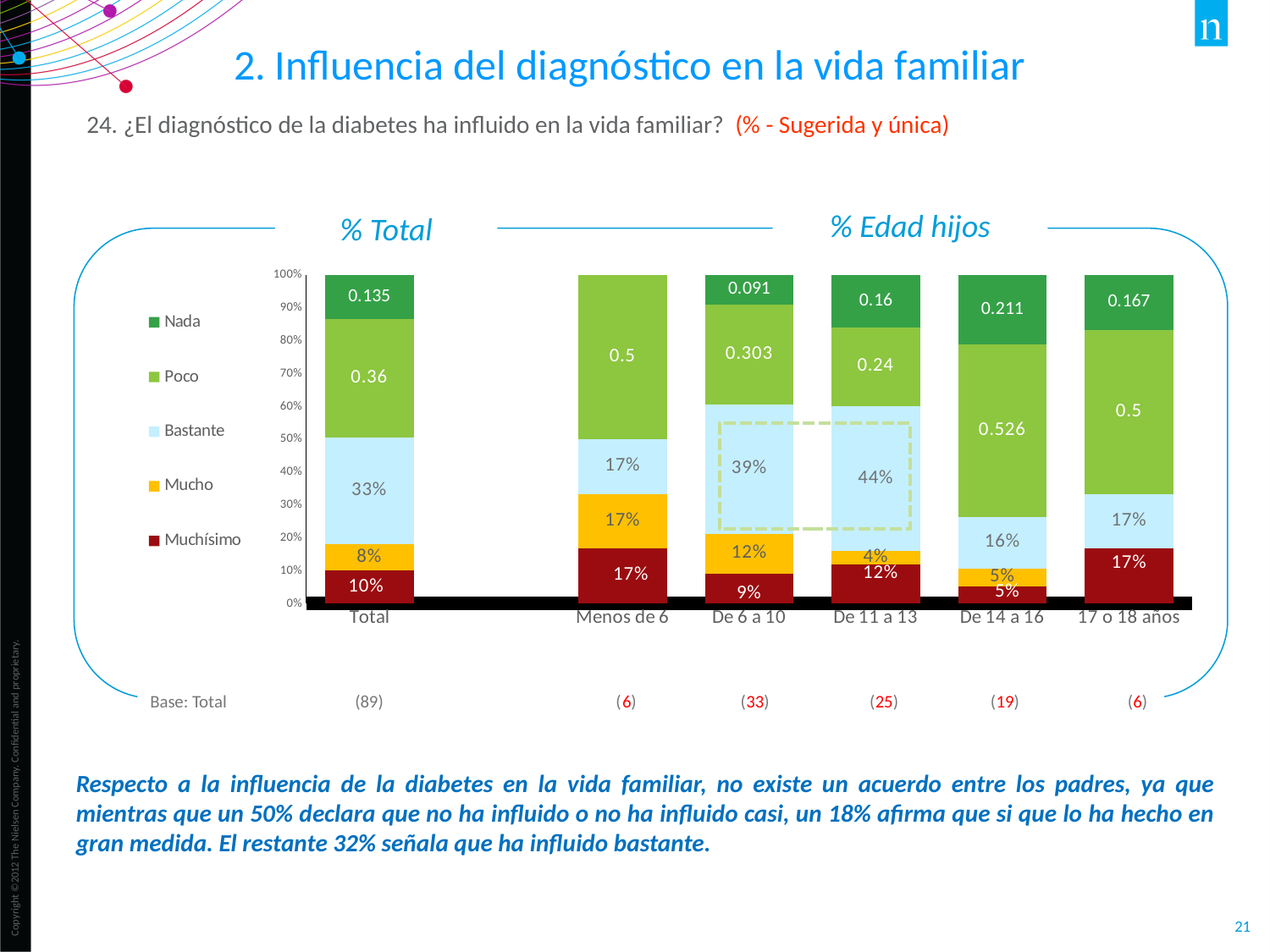
Which category has the lowest Muchísimo value? De 14 a 16 What is the value of the Nada segment for De 6 a 10? 0.091 Which is larger, the Bastante value for De 6 a 10 or for De 14 a 16? De 6 a 10 What is the value of the Bastante segment for the Total bar? 33% What is the value of the Muchísimo segment for Menos de 6? 17% What is the value of the Poco segment for De 14 a 16? 0.526 How many series does the legend list? 5 What is the value of the Mucho segment for De 11 a 13? 4% Which category has the highest Bastante value? De 11 a 13 What is the difference between the Bastante value for De 11 a 13 and for Total? 11 percentage points What kind of chart is shown on the slide? Stacked bar chart How many categories are shown on the x axis? 6